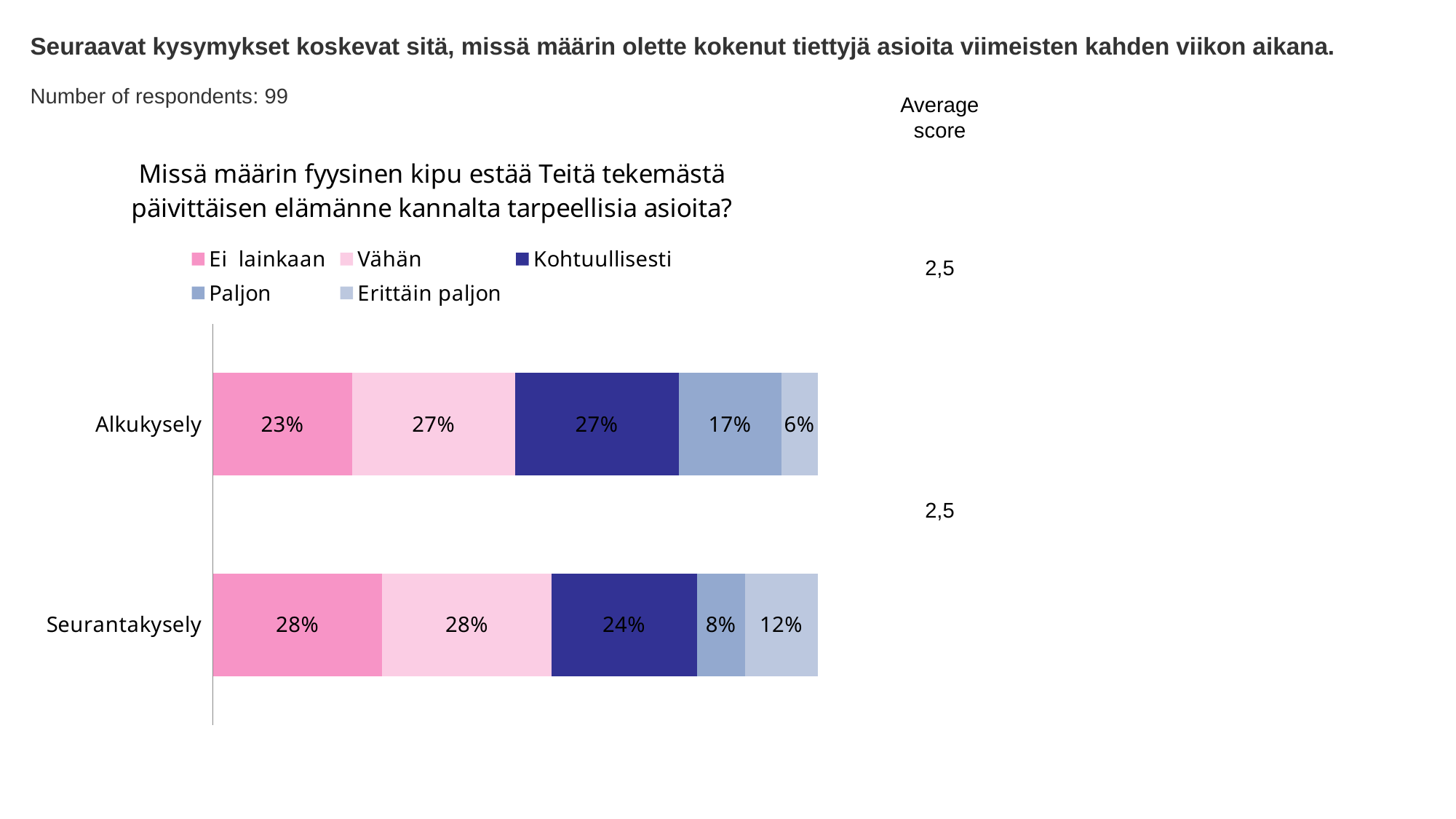
Which response category has the smallest share in the Alkukysely bar? Erittäin paljon What percentage of Alkukysely respondents answered "Ei lainkaan"? 23% Which response category has the smallest share in the Seurantakysely bar? Paljon What percentage of Seurantakysely respondents answered "Erittäin paljon"? 12% How many series does the legend list? 5 What percentage of Seurantakysely respondents answered "Kohtuullisesti"? 24% What percentage of Alkukysely respondents answered "Paljon"? 17% Which survey has a larger "Ei lainkaan" share, Alkukysely or Seurantakysely? Seurantakysely How many bars (survey rounds) are shown in the chart? 2 What is the average score shown for Seurantakysely? 2,5 What kind of chart is shown on the slide? Stacked bar chart What is the difference between the "Paljon" shares for Alkukysely and Seurantakysely? 9 percentage points